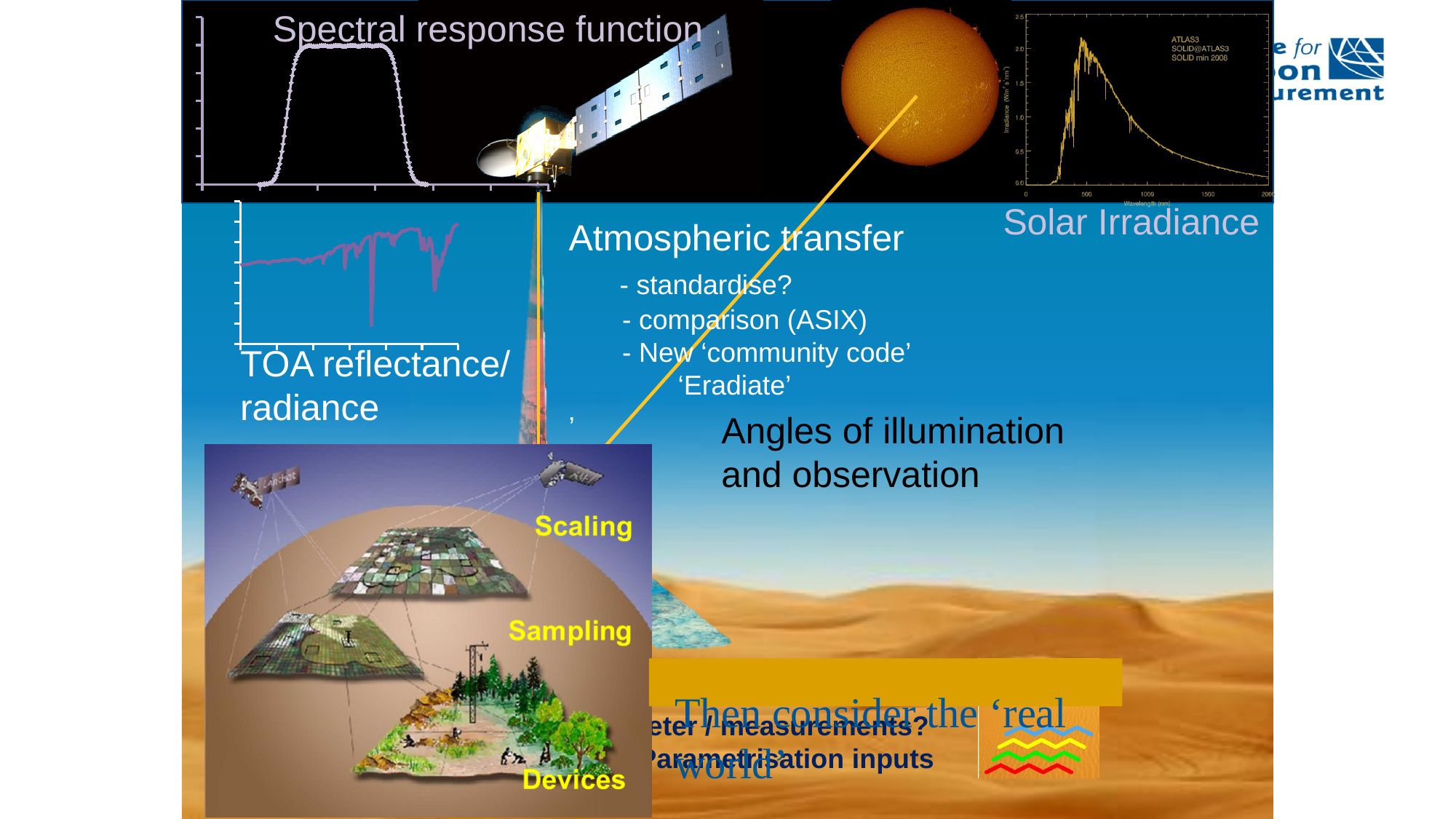
On the Solar Irradiance chart, does the curve rise or fall between 1000 and 2000 nm? fall On the Solar Irradiance chart, is the irradiance at 200 nm greater or less than 0.5? less On the Solar Irradiance chart, is the peak irradiance value greater or less than 1.5? greater What kind of chart is the Spectral response function chart in the top left of the slide? line chart On the Solar Irradiance chart, what is the highest value shown on the x axis? 2000 What kind of chart is the TOA reflectance/radiance chart on the left of the slide? line chart What is the title of the chart in the top left of the slide? Spectral response function On the Solar Irradiance chart, what is the highest value shown on the y axis? 2.5 On the Solar Irradiance chart, is the irradiance at 1500 nm greater or less than 1.0? less What kind of chart is the Solar Irradiance chart in the top right of the slide? line chart